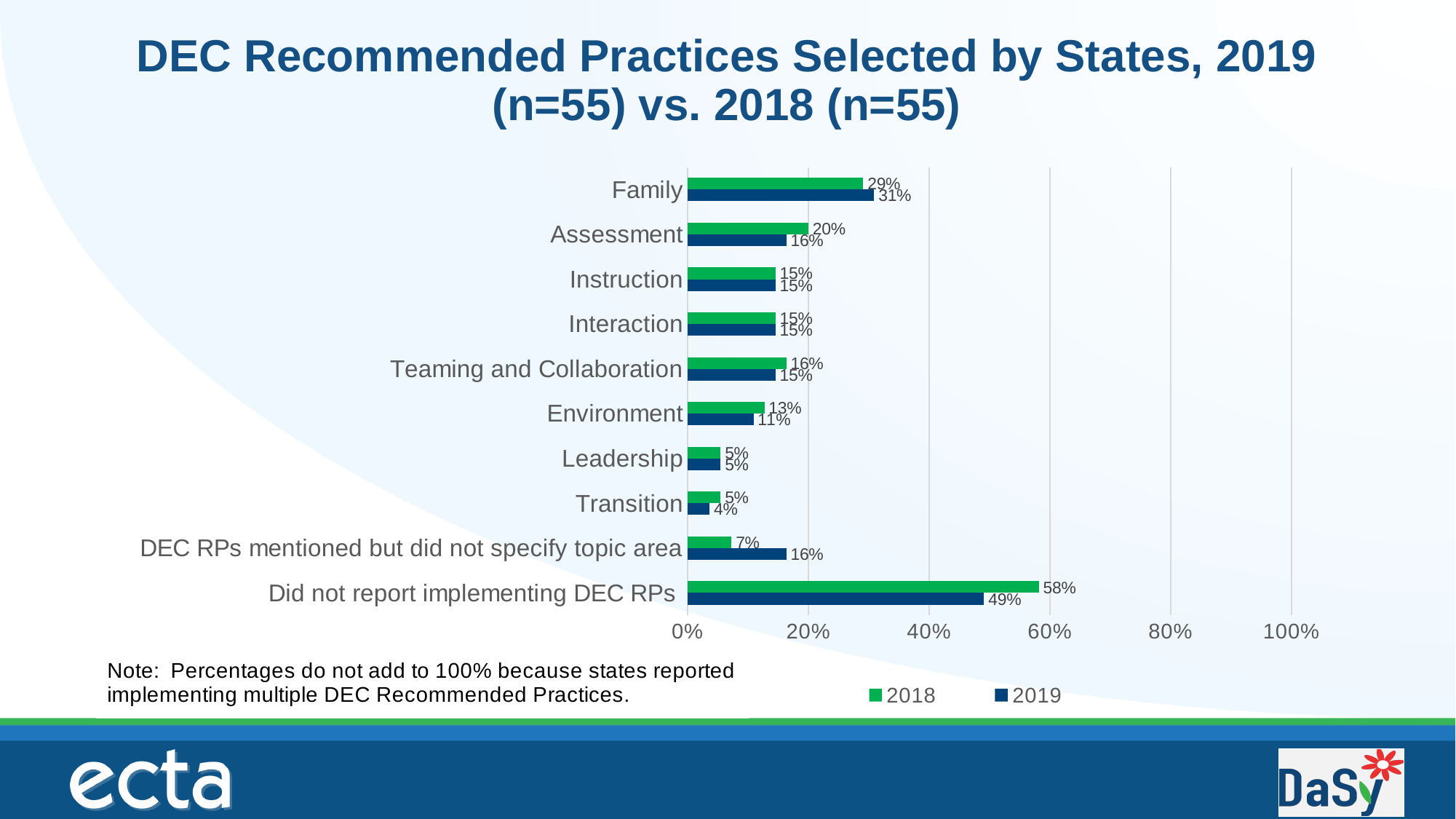
What is the 2019 value for Family? 31% What kind of chart is shown on the slide? bar chart How many series does the legend list? 2 What is the difference between the 2018 and 2019 values for Did not report implementing DEC RPs? 9% Which category has the lowest 2019 value? Transition How many categories are shown on the chart? 10 What is the 2019 value for DEC RPs mentioned but did not specify topic area? 16% Which is larger for Assessment, the 2018 value or the 2019 value? 2018 Which colour represents the 2019 series in the legend? dark blue What is the 2018 value for Assessment? 20% Which category has the highest 2018 value? Did not report implementing DEC RPs Is the 2019 value for Did not report implementing DEC RPs greater or less than 40%? greater